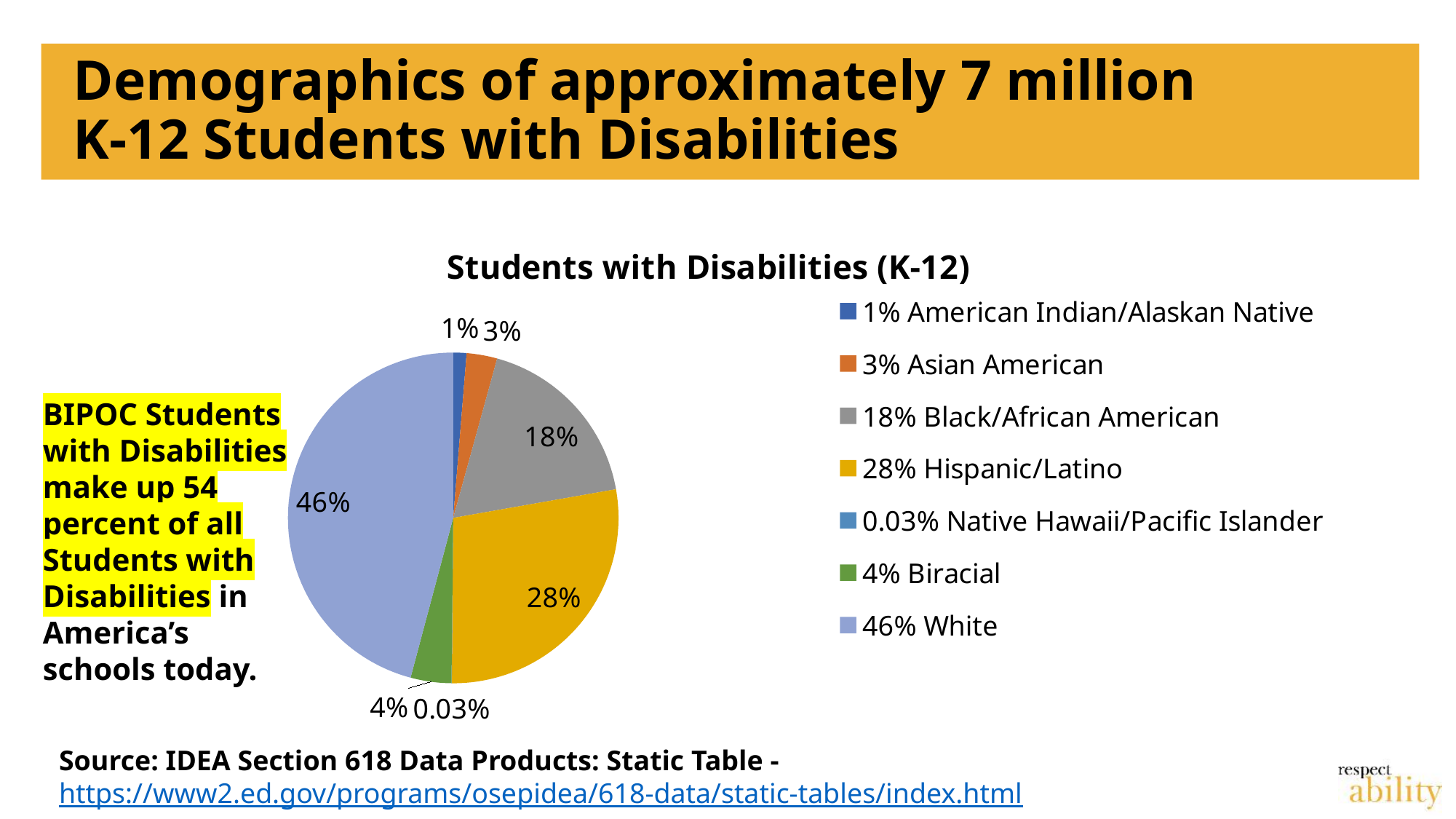
Which is larger, the Asian American share or the Biracial share? Biracial What is the chart's title? Students with Disabilities (K-12) What colour is the slice for Hispanic/Latino? gold/yellow Which group has the largest share of the pie? White What is the difference between the White share and the Hispanic/Latino share? 18% How many categories does the legend list? 7 What percentage of students with disabilities are Black/African American? 18% What type of chart is shown on the slide? pie chart What percentage of students with disabilities are Biracial? 4% What percentage of students with disabilities are Hispanic/Latino? 28% Which group has the smallest share of the pie? Native Hawaii/Pacific Islander What percentage of students with disabilities are Native Hawaii/Pacific Islander? 0.03%